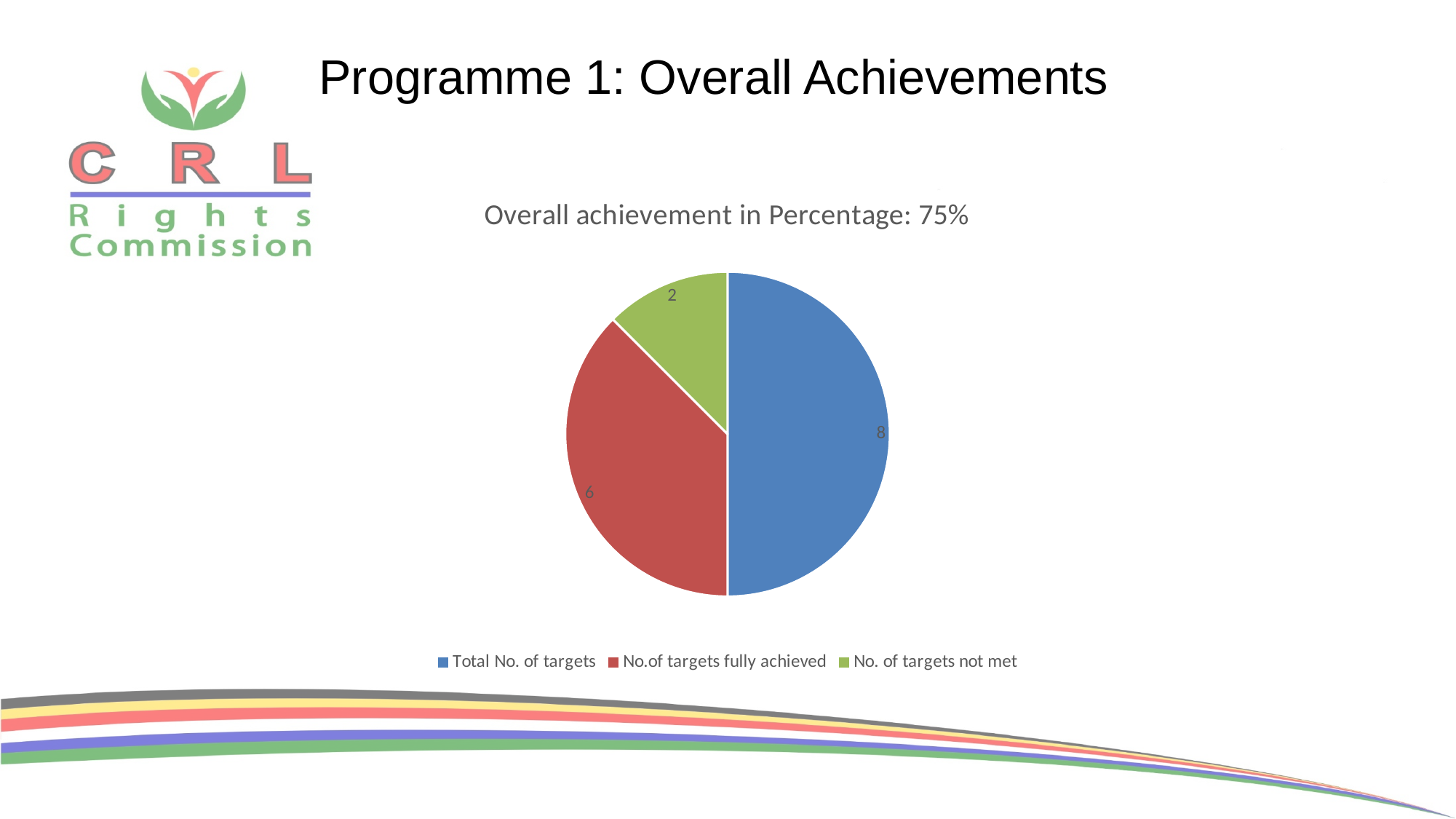
What colour is the slice for No. of targets not met? Green Which category has the smallest slice of the pie? No. of targets not met What is the difference between the value for No.of targets fully achieved and the value for No. of targets not met? 4 What share of the pie does the Total No. of targets slice represent? 50% Which category has the largest slice of the pie? Total No. of targets What kind of chart is shown on the slide? Pie chart What is the title of the chart? Overall achievement in Percentage: 75% What is the value for No.of targets fully achieved? 6 How many slices does the pie chart have? 3 Which is larger: the value for Total No. of targets or the value for No.of targets fully achieved? Total No. of targets What is the value for Total No. of targets? 8 What is the value for No. of targets not met? 2